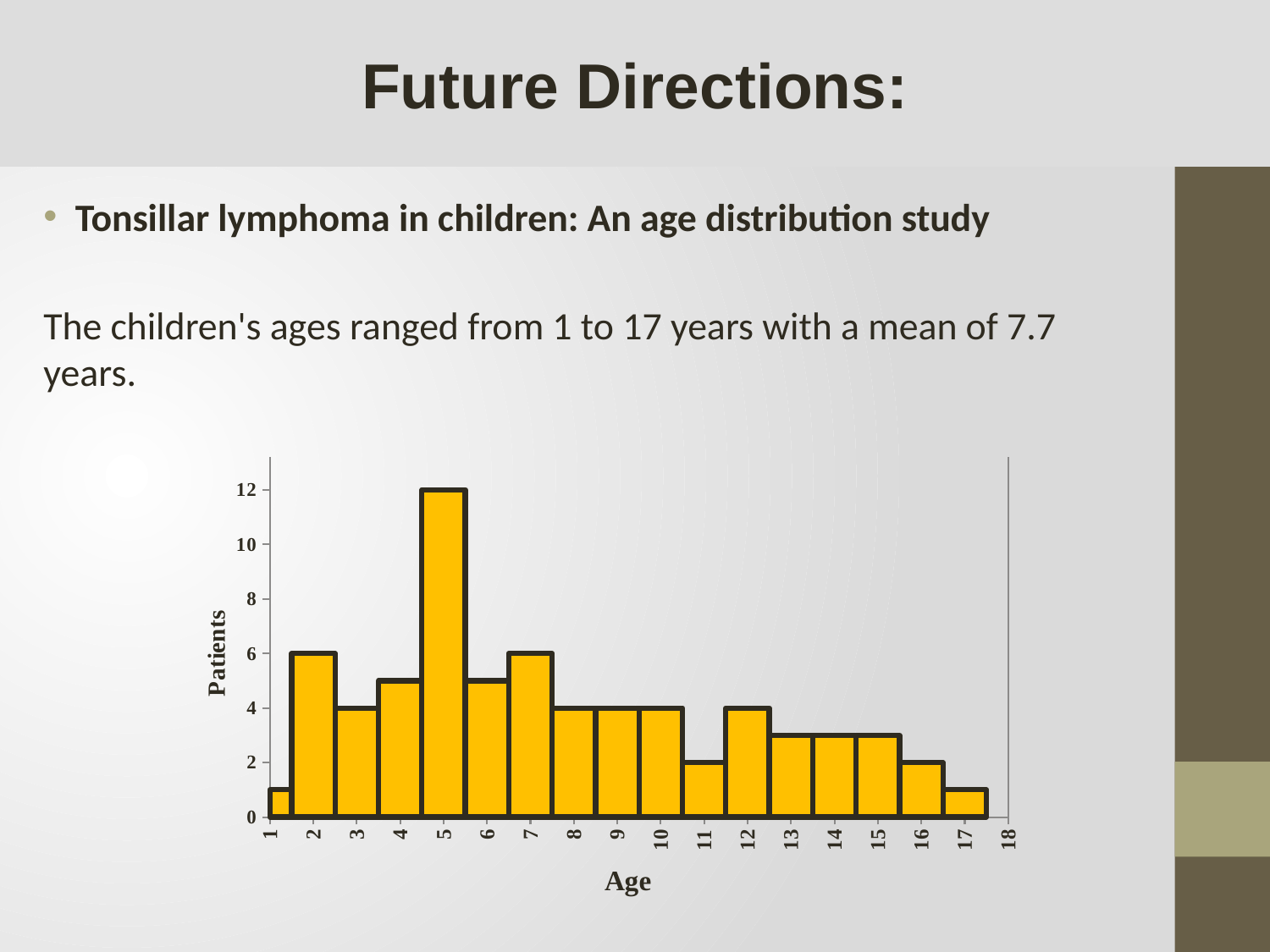
Is the number of patients for age 13 greater or less than 4? less Which age has the highest number of patients? 5 Which has more patients, age 2 or age 3? age 2 What is the label on the vertical axis of the chart? Patients How many age bars are plotted in the chart? 17 What kind of chart is shown on the slide? bar chart Is the number of patients for age 4 greater or less than 4? greater How many patients are shown for age 11? 2 From age 12 to age 17, do the patient counts generally rise or fall? fall How many patients are shown for age 2? 6 What is the difference in patients between age 5 and age 2? 6 How many patients are shown for age 5? 12